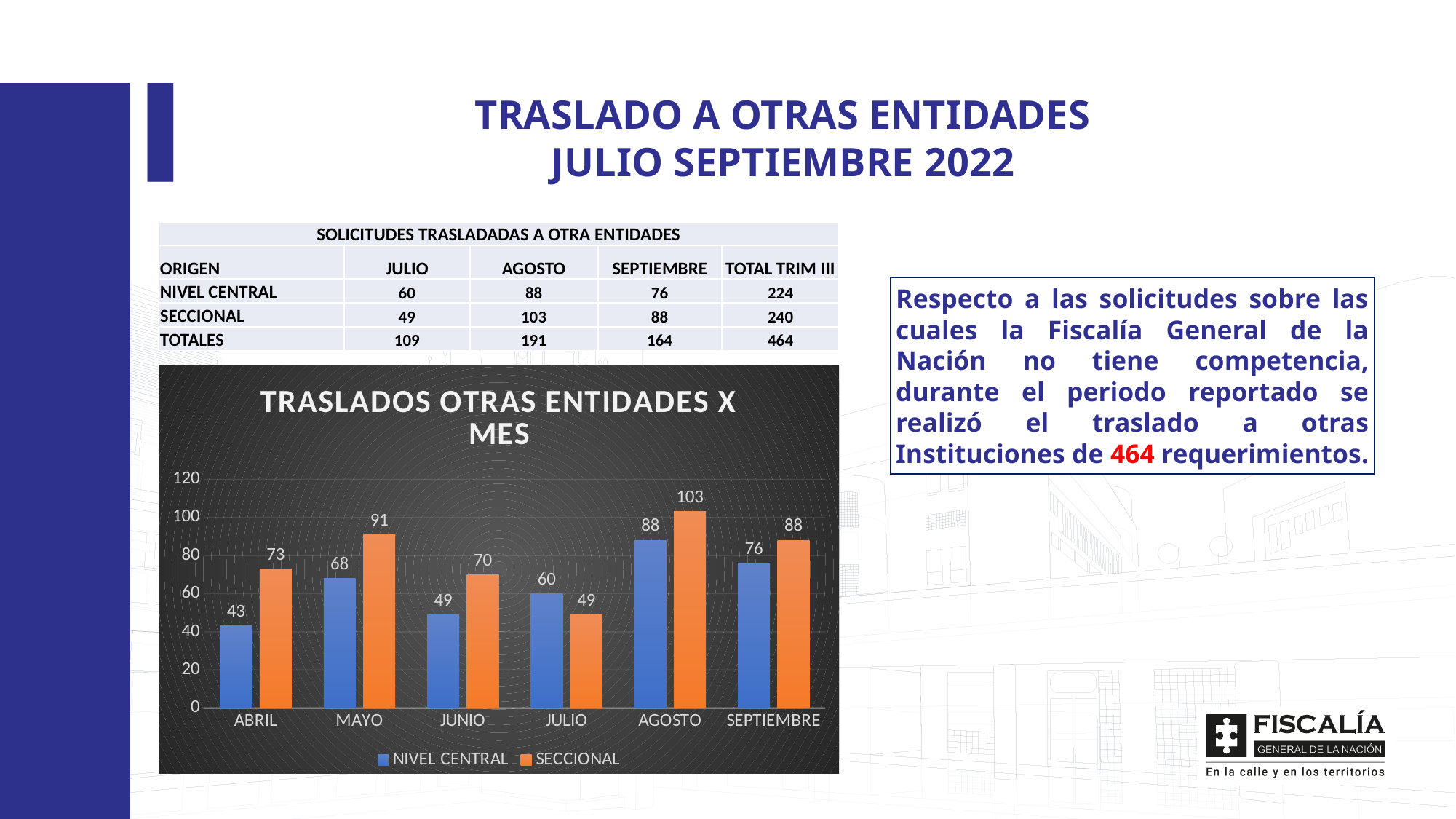
What is the NIVEL CENTRAL value for AGOSTO in the chart? 88 In JULIO, which series has the larger value, NIVEL CENTRAL or SECCIONAL? NIVEL CENTRAL What kind of chart is shown on the slide? Bar chart Is the SECCIONAL value for AGOSTO greater or less than 100? greater Which month has the lowest NIVEL CENTRAL value in the chart? ABRIL What is the SECCIONAL value for MAYO in the chart? 91 What is the title of the chart? TRASLADOS OTRAS ENTIDADES X MES Which colour represents the SECCIONAL series in the chart? Orange Which month has the highest SECCIONAL value in the chart? AGOSTO What is the difference between the SECCIONAL and NIVEL CENTRAL values for ABRIL? 30 How many series does the chart legend list? 2 How many months are shown on the x axis of the chart? 6